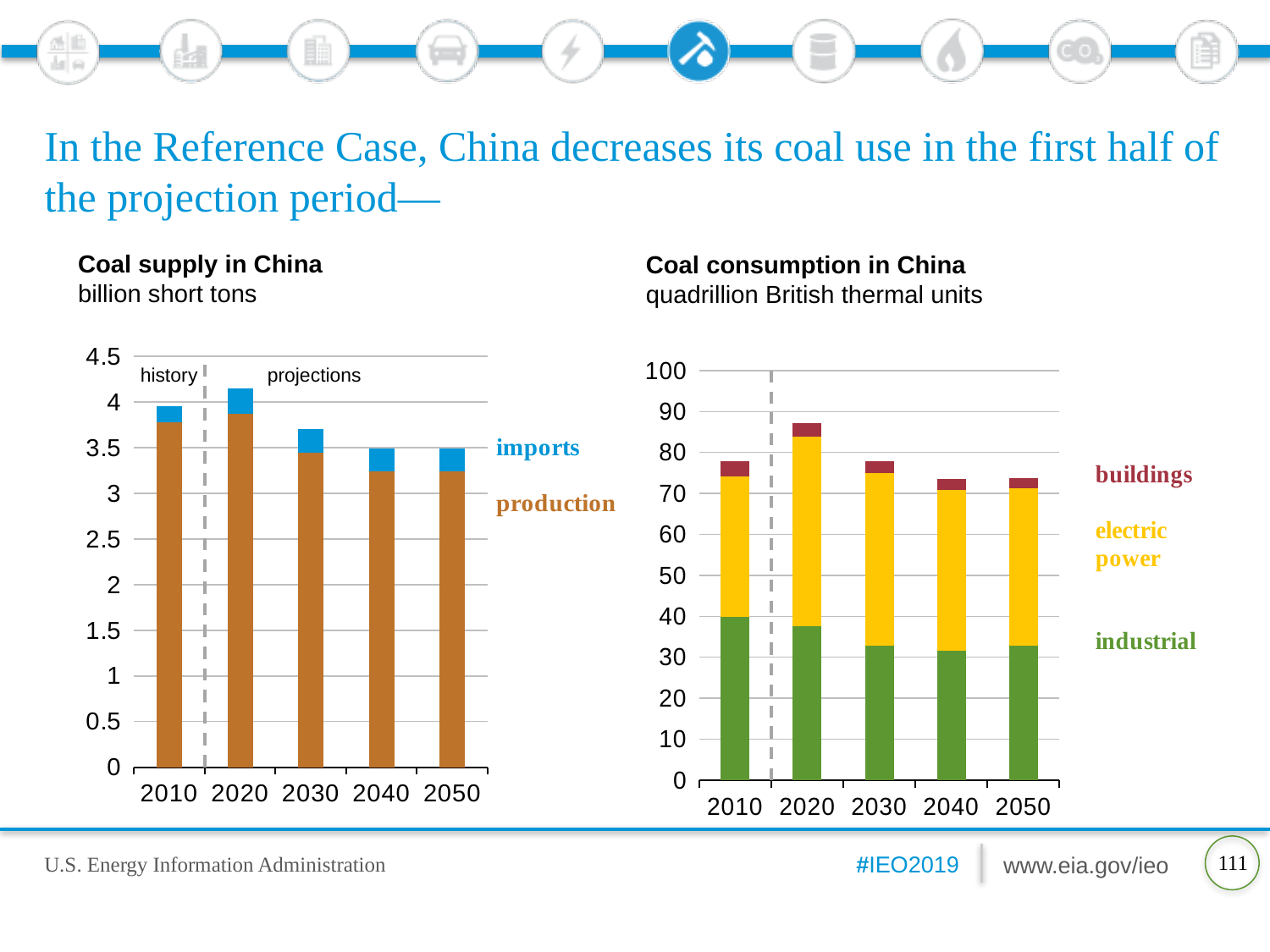
In the Coal supply in China chart, how many series does the legend list? 2 In the Coal consumption in China chart, which year has the highest total coal consumption? 2020 In the Coal supply in China chart, what kind of chart is shown? bar chart In the Coal consumption in China chart, how many series does the legend list? 3 In the Coal consumption in China chart, is the industrial value in 2040 greater or less than 30? greater In the Coal supply in China chart, what unit is the y axis measured in? billion short tons In the Coal supply in China chart, how many years are shown on the x axis? 5 In the Coal supply in China chart, is the production value in 2040 greater or less than 3.5? less In the Coal consumption in China chart, is the total coal consumption in 2020 greater or less than 80? greater In the Coal consumption in China chart, which is larger, the industrial value in 2010 or in 2040? 2010 In the Coal supply in China chart, which year has the highest total coal supply? 2020